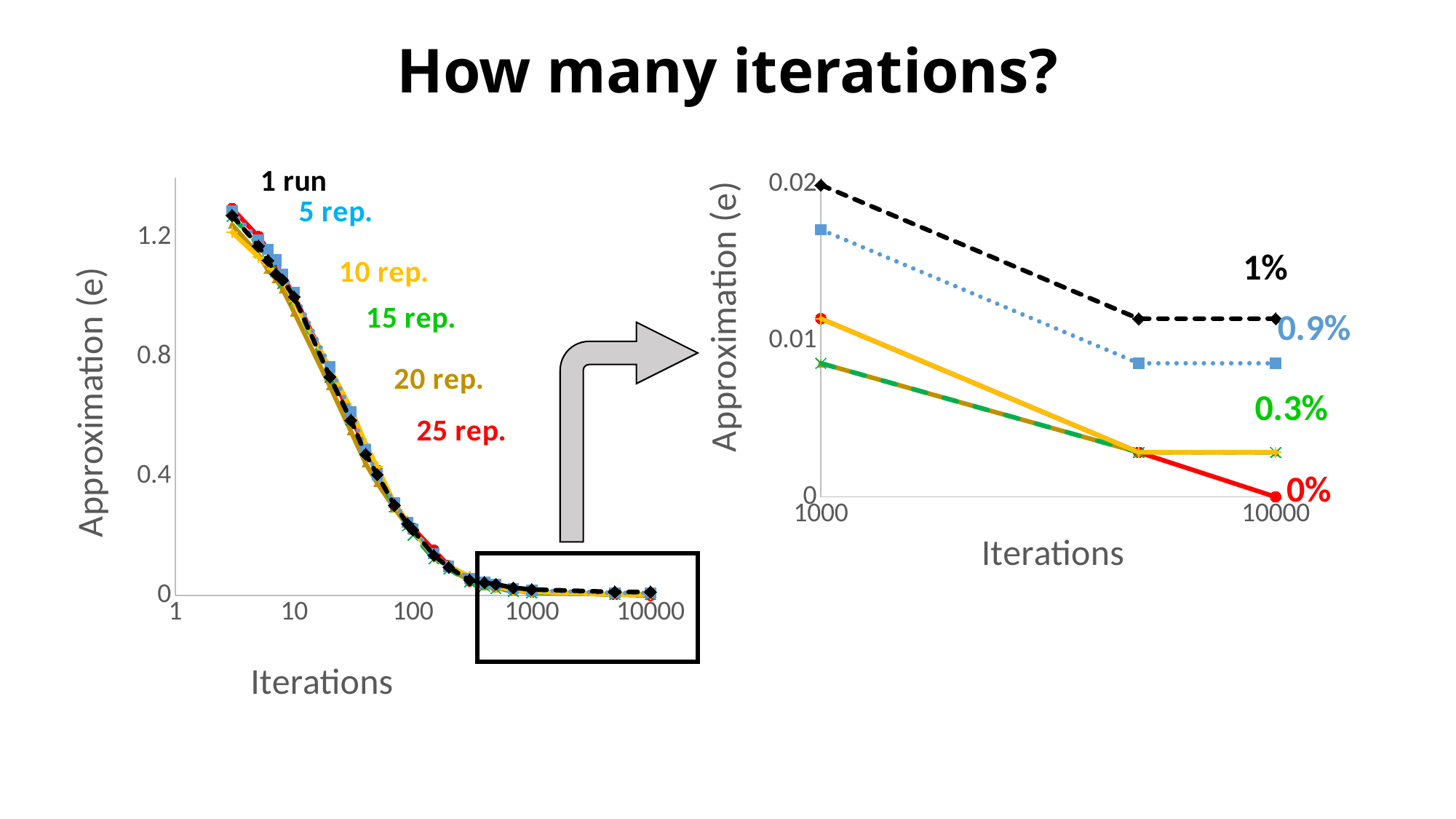
In the right (zoomed) chart, is the value for 5 rep. at 10000 iterations greater or less than 0.01? less What is the x-axis label of the right (zoomed) chart? Iterations In the right (zoomed) chart, which is larger at 1000 iterations: the value for 1 run or the value for 5 rep.? 1 run In the left chart, do the values rise or fall as the number of iterations increases? fall In the right (zoomed) chart, which series has the lowest value at 10000 iterations? 25 rep. In the left chart, is the value for 1 run at 100 iterations greater or less than 0.4? less In the right (zoomed) chart, which series has the highest value at 1000 iterations? 1 run In the left chart, is the value for 1 run at 10 iterations greater or less than 0.8? greater What is the y-axis label of the left chart? Approximation (e) What kind of chart is the left chart on the slide? line chart In the left chart, how many series are labelled? 6